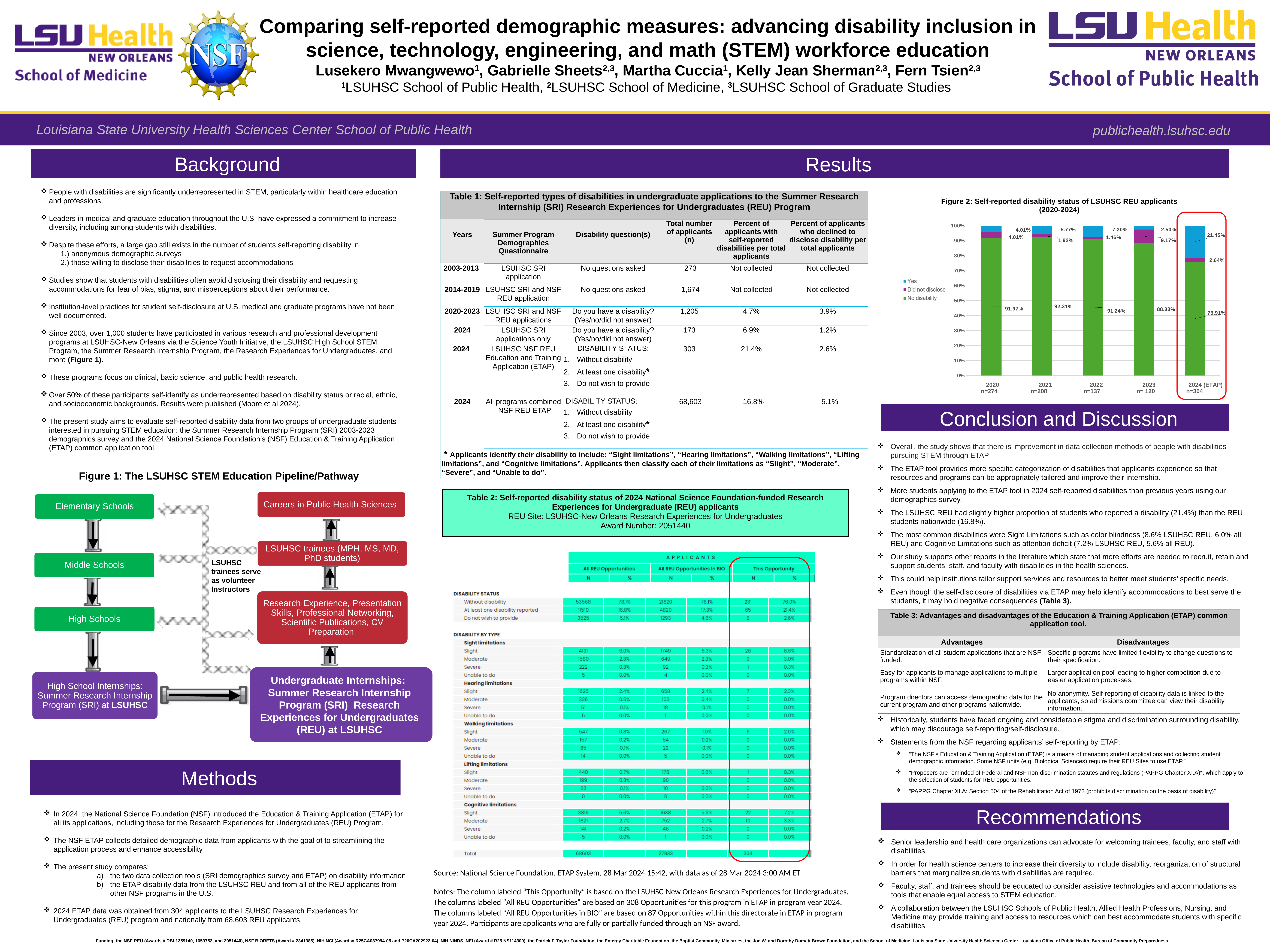
In Figure 2, what is the 'Did not disclose' percentage for 2024 (ETAP)? 2.64% In Figure 2, which year has the lowest 'No disability' percentage? 2024 (ETAP) In Figure 2, what is the 'No disability' percentage for 2020? 91.97% In Figure 2, what is the 'No disability' percentage for 2023? 88.33% In Figure 2, what is the number of applicants (n) shown for 2022? n=137 In Figure 2, which year has the highest 'No disability' percentage? 2021 In Figure 2, what is the difference between the 'No disability' percentage in 2021 and in 2024 (ETAP)? 16.40% In Figure 2, how many series does the legend list? 3 In Figure 2, is the 'No disability' value for 2024 (ETAP) greater or less than 80%? less In Figure 2, what is the 'Yes' percentage for 2024 (ETAP)? 21.45% In Figure 2, how many year categories are shown on the x axis? 5 What kind of chart is Figure 2? stacked bar chart